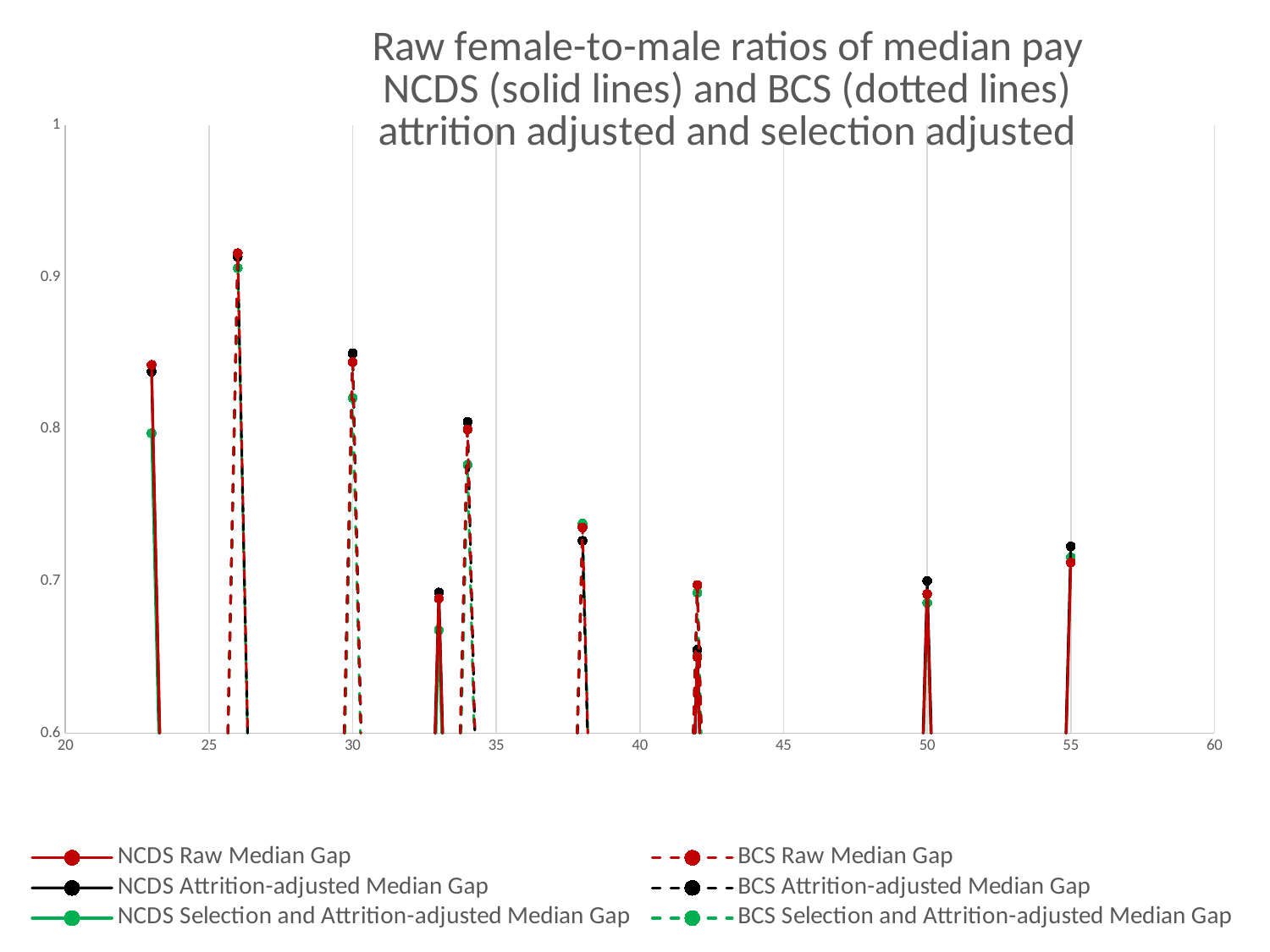
How many series does the legend list? 6 Is the peak value of the NCDS Raw Median Gap at age 23 greater or less than 0.8? greater At which age on the x axis do the series reach their highest peak? 26 Which is larger: the peak value at age 26 or the peak value at age 38? age 26 Is the peak value of the NCDS Attrition-adjusted Median Gap at age 55 greater or less than 0.7? greater Is the peak value of the NCDS Raw Median Gap at age 33 greater or less than 0.7? less Which line style is used for the BCS series according to the legend? dotted lines What is the title of the chart? Raw female-to-male ratios of median pay NCDS (solid lines) and BCS (dotted lines) attrition adjusted and selection adjusted What kind of chart is shown on the slide? line chart